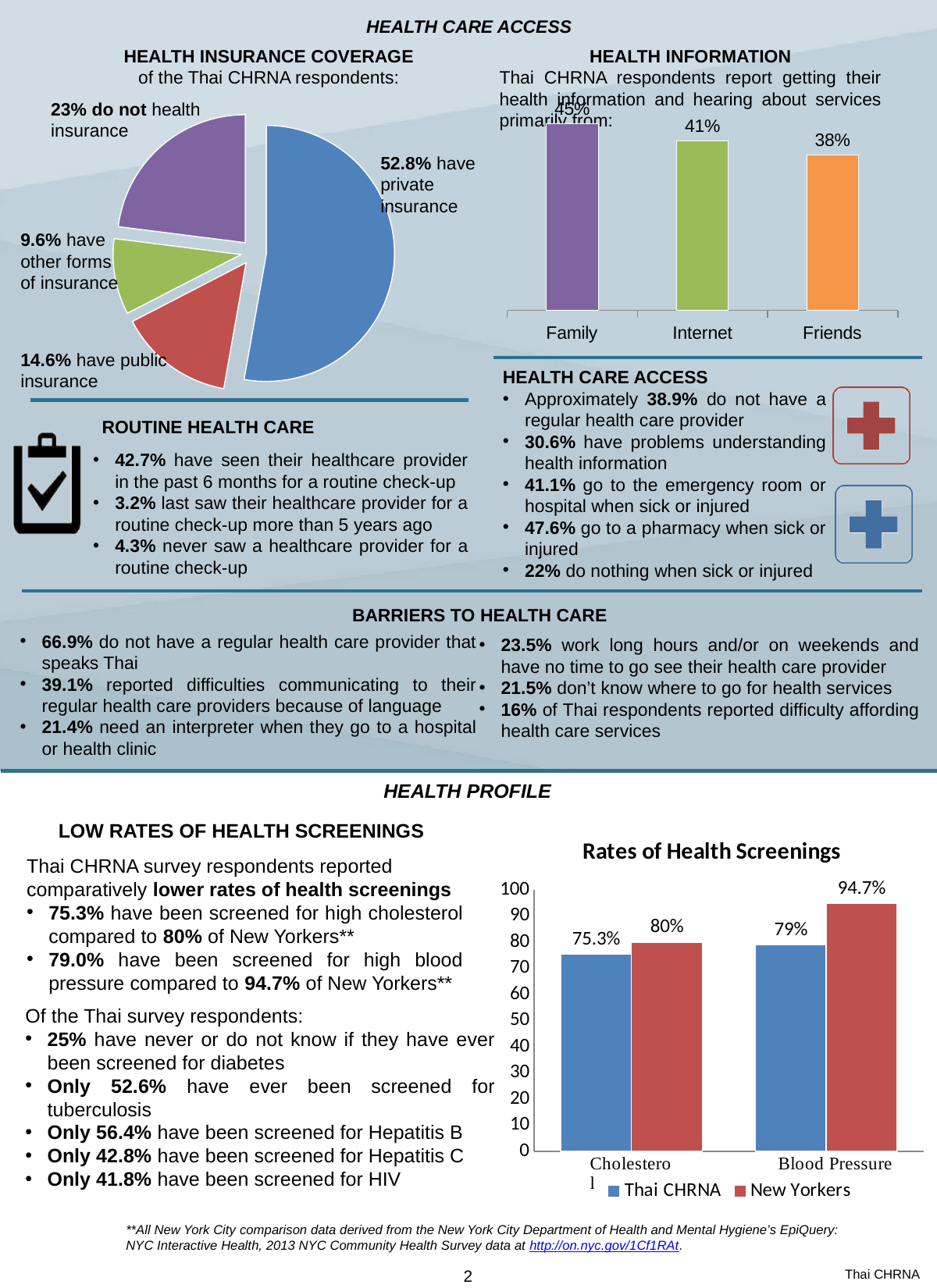
In the health information bar chart, what percentage of respondents get their health information from the Internet? 41% In the health insurance coverage pie chart, which slice is the smallest? have other forms of insurance (9.6%) In the health information bar chart, what is the difference between the Family and Friends values? 7% In the health insurance coverage pie chart, how many slices are there? 4 In the health insurance coverage pie chart, what share of respondents have public insurance? 14.6% In the Rates of Health Screenings chart, what is the difference between New Yorkers and Thai CHRNA for Cholesterol? 4.7% In the Rates of Health Screenings chart, how many series does the legend list? 2 In the Rates of Health Screenings chart, which is larger for Blood Pressure: Thai CHRNA or New Yorkers? New Yorkers In the health information bar chart, which source has the highest value? Family What type of chart is the health information chart showing Family, Internet and Friends? bar chart In the Rates of Health Screenings chart, what is the value for New Yorkers for Blood Pressure? 94.7% In the health insurance coverage pie chart, what share of respondents have private insurance? 52.8%